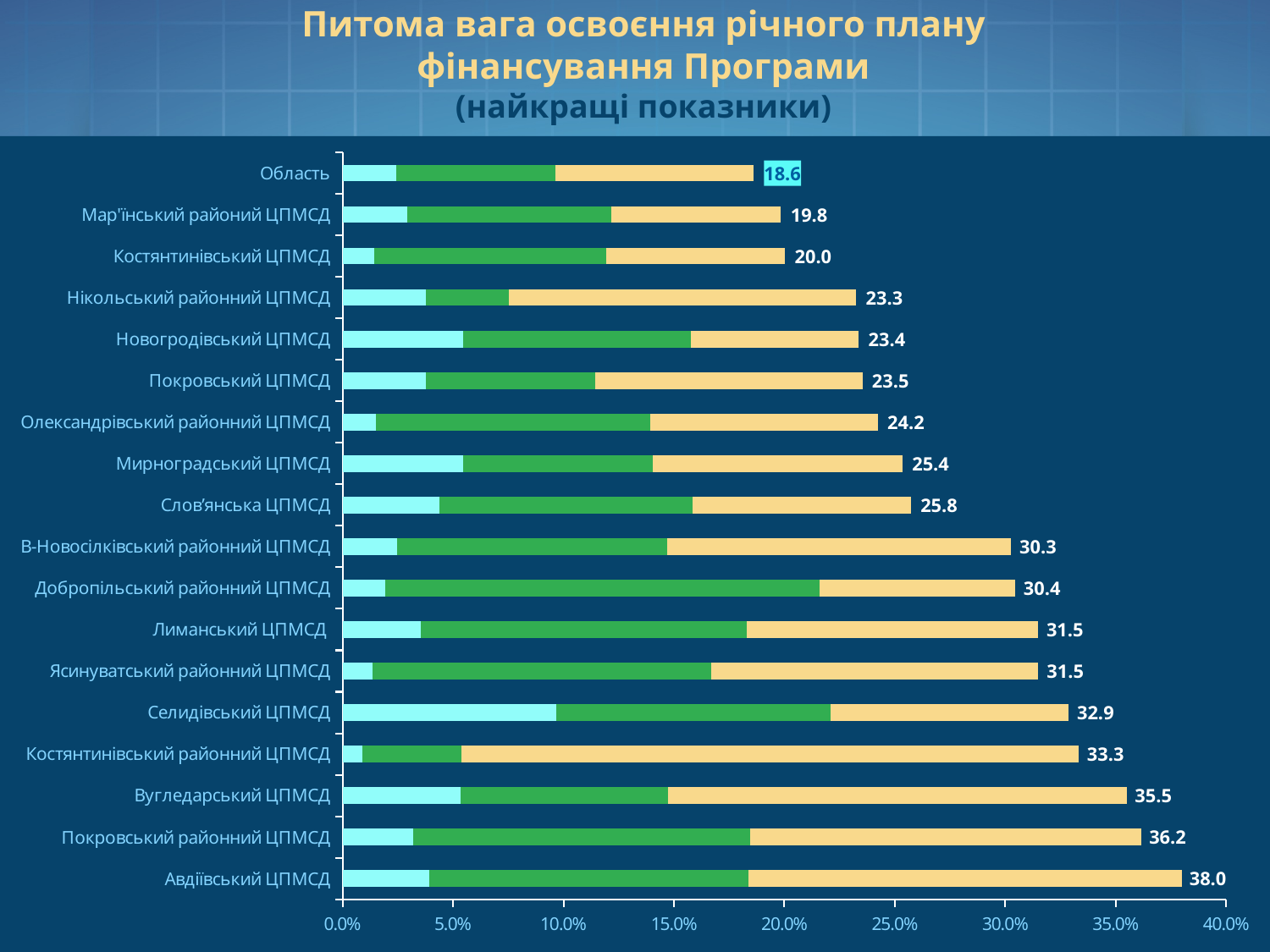
What is the difference between the labelled values for Покровський районний ЦПМСД and Покровський ЦПМСД? 12.7 What is the value labelled for Область? 18.6 Which category has the lowest labelled value? Область What is the value labelled for Селидівський ЦПМСД? 32.9 What type of chart is shown on the slide? bar chart What is the main title of the chart? Питома вага освоєння річного плану фінансування Програми How many categories are plotted on the chart? 18 Do the labelled values increase or decrease going from the top category to the bottom category? increase Which has a larger labelled value, Вугледарський ЦПМСД or Костянтинівський районний ЦПМСД? Вугледарський ЦПМСД What is the value labelled for Авдіївський ЦПМСД? 38.0 Is the cyan (first) segment of the bar for Селидівський ЦПМСД greater or less than 5.0%? greater Which category has the highest labelled value? Авдіївський ЦПМСД